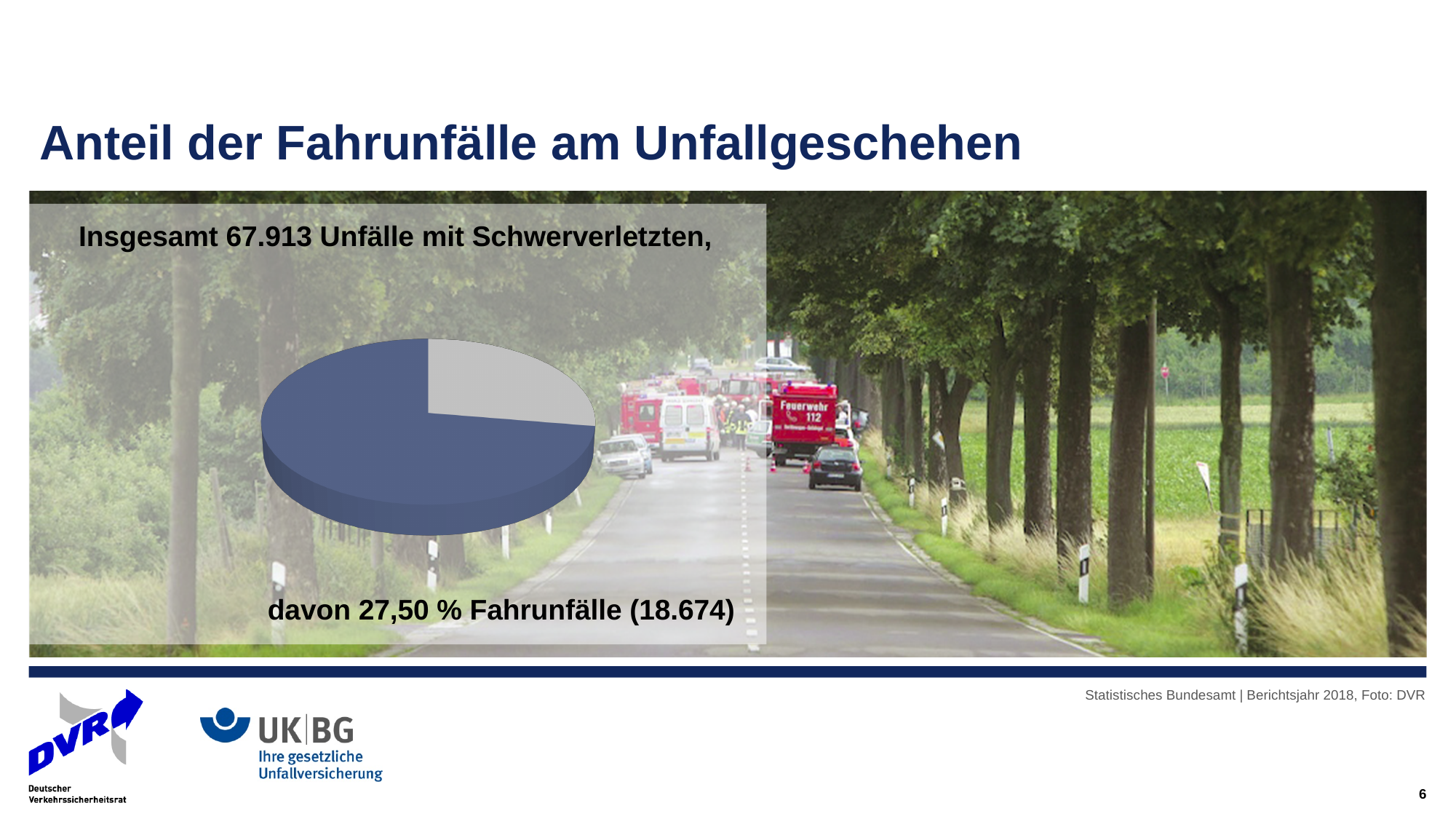
What share of the accidents with seriously injured persons are Fahrunfälle according to the slide? 27,50 % How many Fahrunfälle are reported on the slide? 18.674 What is the total number of Unfälle mit Schwerverletzten given on the slide? 67.913 Is the share represented by the grey slice greater or less than 50%? less What colour is the smaller slice of the pie chart? grey Which slice of the pie chart is larger, the dark blue one or the grey one? the dark blue one Which reporting year is the data on the slide from? 2018 What is the title of the slide containing the pie chart? Anteil der Fahrunfälle am Unfallgeschehen How many slices does the pie chart have? 2 What kind of chart is shown on the slide? pie chart Is the share represented by the dark blue slice greater or less than 50%? greater